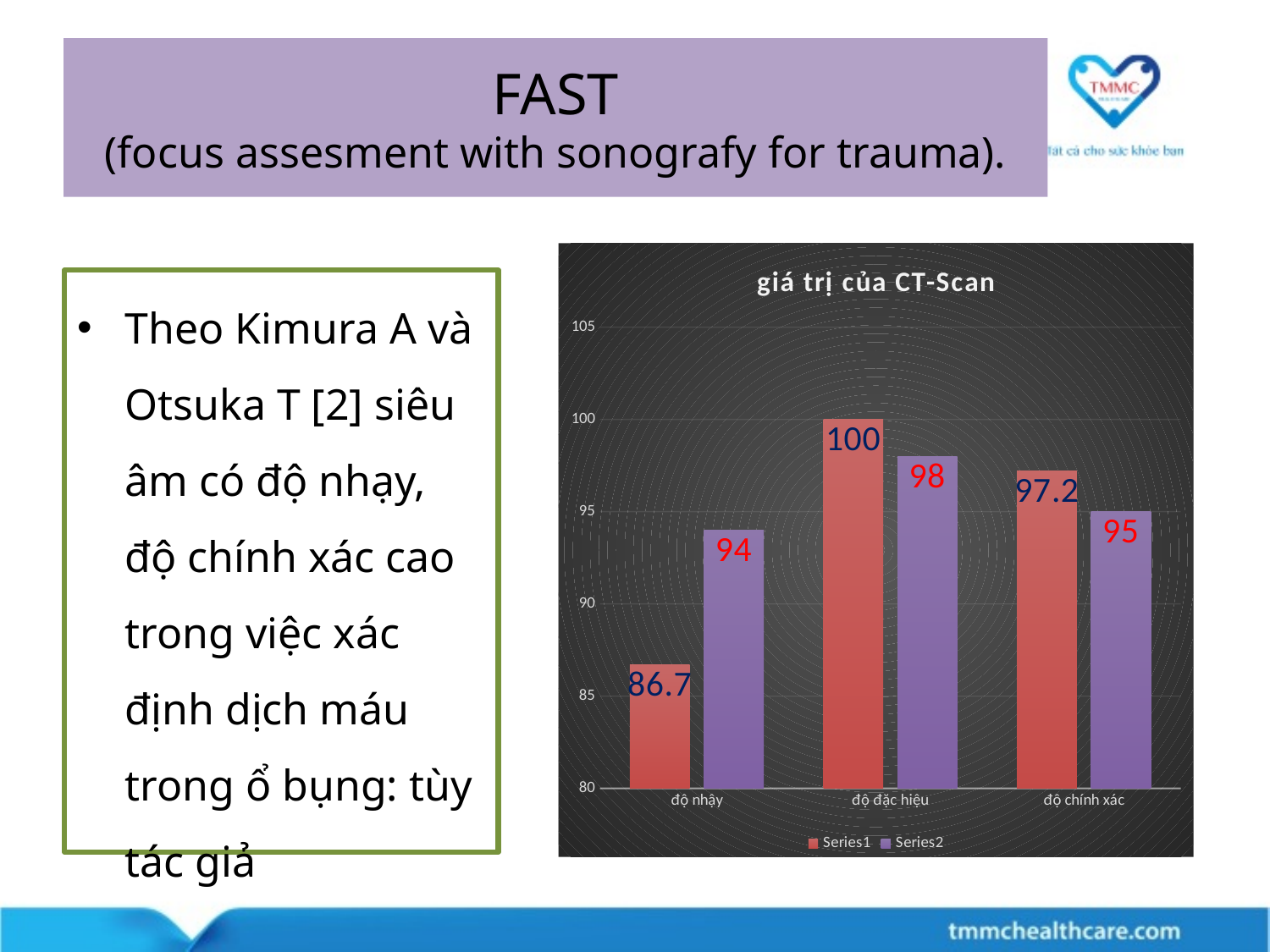
What is the difference between Series1 and Series2 for độ nhạy? 7.3 What kind of chart is shown on the slide? bar chart What is the value of Series2 for độ nhạy? 94 How many categories are shown on the x axis? 3 Which is larger for độ chính xác, Series1 or Series2? Series1 What is the value of Series1 for độ nhạy? 86.7 What is the title of the chart? giá trị của CT-Scan How many series does the legend list? 2 Which category has the highest Series1 value? độ đặc hiệu What is the value of Series1 for độ chính xác? 97.2 What is the value of Series2 for độ đặc hiệu? 98 Which category has the lowest Series2 value? độ nhạy